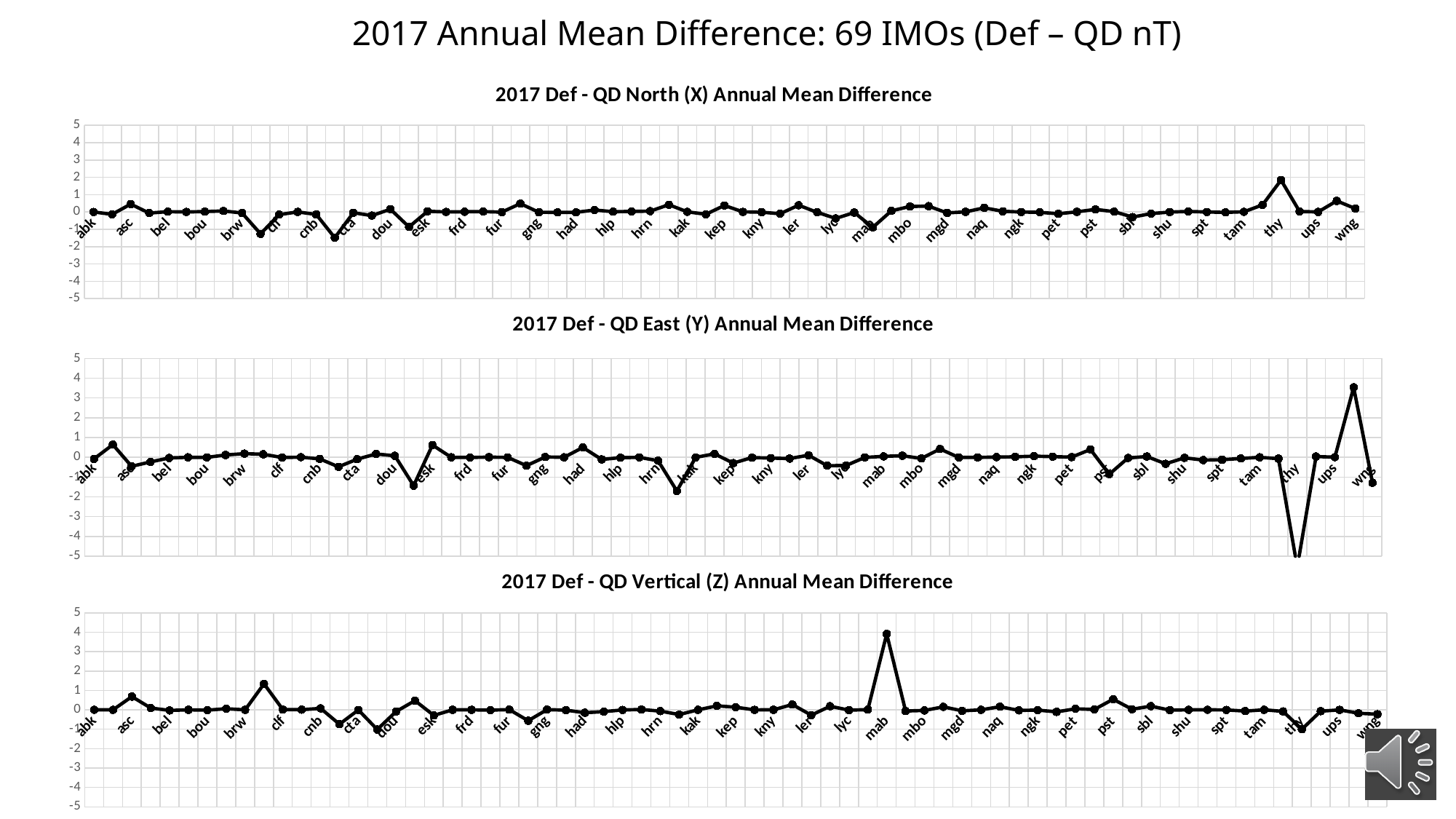
In the '2017 Def - QD East (Y) Annual Mean Difference' chart, which station has the lowest value? thy In the '2017 Def - QD East (Y) Annual Mean Difference' chart, which is larger, the value for thy or the value for mab? mab How many charts are shown on the slide? 3 In the '2017 Def - QD North (X) Annual Mean Difference' chart, which station has the highest value? thy What kind of chart is the '2017 Def - QD North (X) Annual Mean Difference' chart? line chart In the '2017 Def - QD North (X) Annual Mean Difference' chart, is the value for thy greater or less than 1? greater In the '2017 Def - QD Vertical (Z) Annual Mean Difference' chart, which is larger, the value for mab or the value for abk? mab In the '2017 Def - QD East (Y) Annual Mean Difference' chart, is the value for thy greater or less than -3? less In the '2017 Def - QD Vertical (Z) Annual Mean Difference' chart, which station has the highest value? mab In the '2017 Def - QD Vertical (Z) Annual Mean Difference' chart, is the value for mab greater or less than 3? greater What is the title of the middle chart on the slide? 2017 Def - QD East (Y) Annual Mean Difference According to the slide title, how many IMOs are included in the 2017 annual mean difference? 69